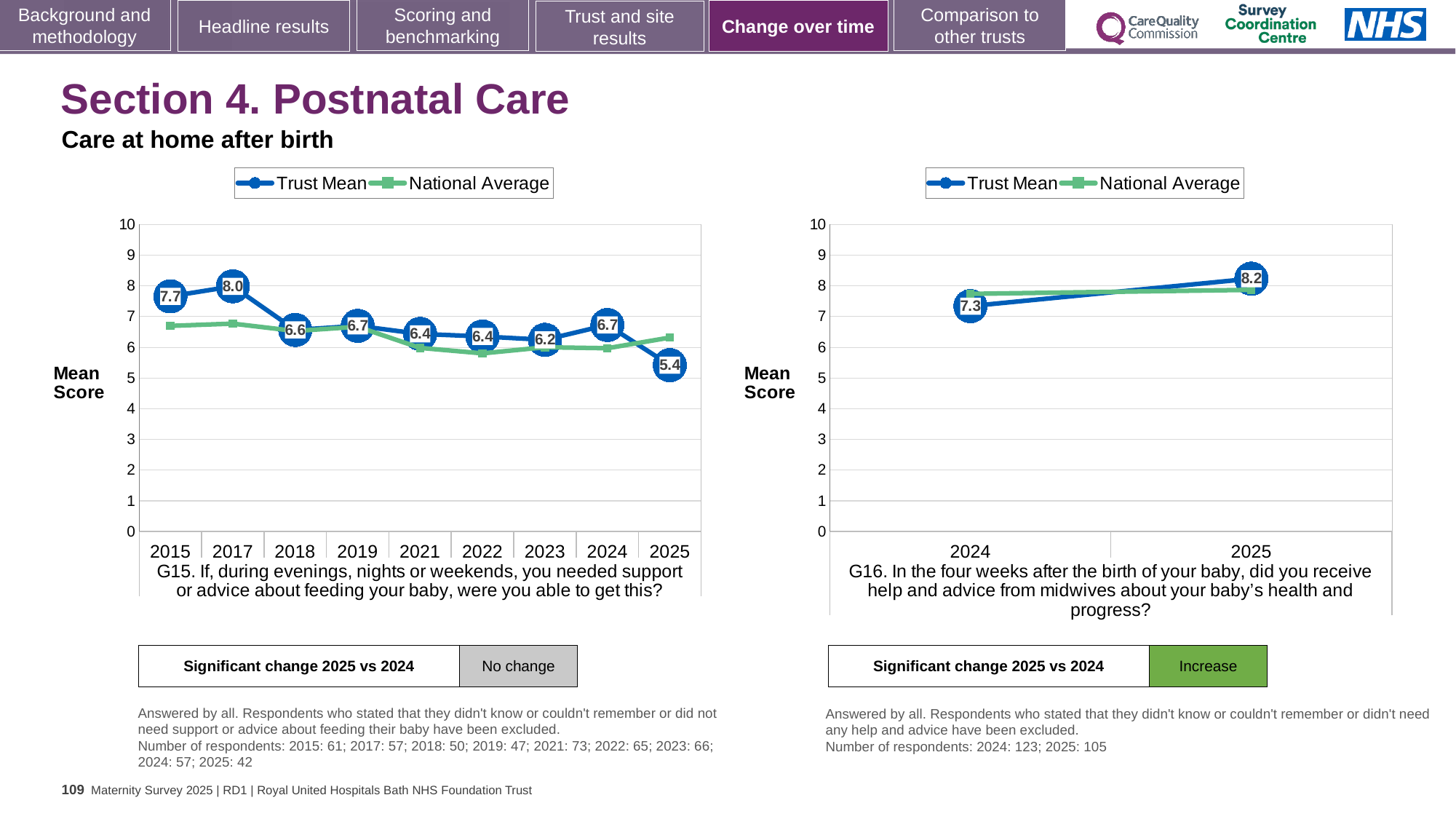
In the G15 chart on the left, is the Trust Mean score higher in 2015 or in 2018? 2015 In the G16 chart on the right, what is the Trust Mean score for 2024? 7.3 In the G15 chart on the left, what is the Trust Mean score for 2025? 5.4 In the G15 chart on the left, what is the difference between the Trust Mean scores for 2024 and 2025? 1.3 How many years are shown on the x axis of the G15 chart on the left? 9 In the G15 chart on the left, is the National Average value for 2015 greater or less than 7? less In the G16 chart on the right, what is the difference between the Trust Mean scores for 2025 and 2024? 0.9 In the G15 chart on the left, which year has the highest Trust Mean score? 2017 In the G16 chart on the right, does the Trust Mean rise or fall from 2024 to 2025? rise In the G15 chart on the left, what is the Trust Mean score for 2017? 8.0 How many series does the legend of the G16 chart on the right list? 2 In the G15 chart on the left, which year has the lowest Trust Mean score? 2025